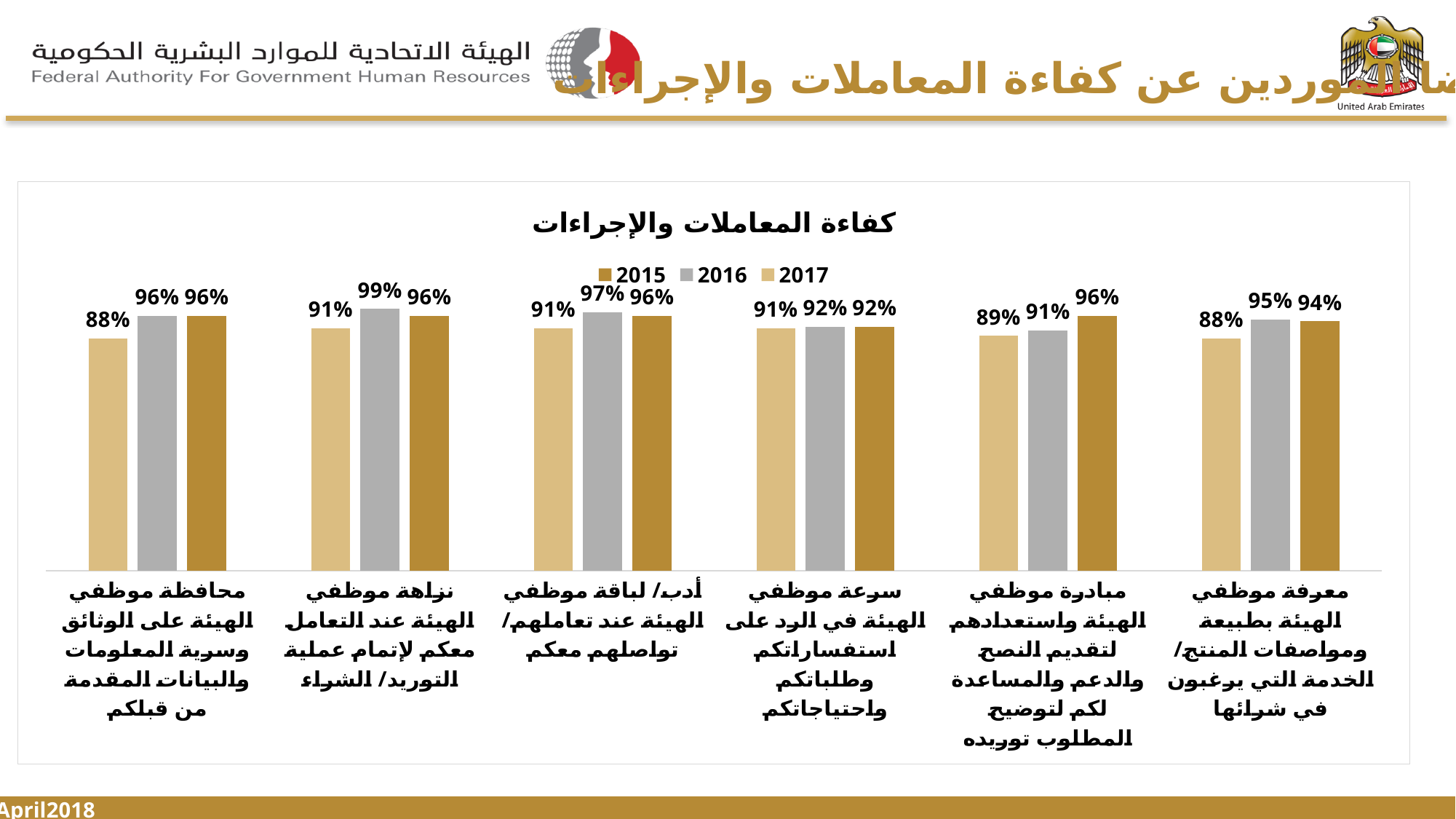
How many categories are shown on the x axis of the chart? 6 For "مبادرة موظفي الهيئة واستعدادهم لتقديم النصح والدعم والمساعدة لكم لتوضيح المطلوب توريده", which is larger, the 2015 value or the 2017 value? 2015 What is the 2016 value for "معرفة موظفي الهيئة بطبيعة ومواصفات المنتج/ الخدمة التي يرغبون في شرائها"? 95% What is the title of the chart? كفاءة المعاملات والإجراءات What is the 2016 value for "نزاهة موظفي الهيئة عند التعامل معكم لإتمام عملية التوريد/ الشراء"? 99% How many series does the legend of the chart list? 3 What type of chart is shown on the slide? Bar chart What is the difference between the 2016 and 2017 values for "محافظة موظفي الهيئة على الوثائق وسرية المعلومات والبيانات المقدمة من قبلكم"? 8% Which category has the lowest 2015 value? سرعة موظفي الهيئة في الرد على استفساراتكم وطلباتكم واحتياجاتكم What is the 2015 value for "مبادرة موظفي الهيئة واستعدادهم لتقديم النصح والدعم والمساعدة لكم لتوضيح المطلوب توريده"? 96% What is the 2017 value for "محافظة موظفي الهيئة على الوثائق وسرية المعلومات والبيانات المقدمة من قبلكم"? 88% Which category has the highest 2016 value? نزاهة موظفي الهيئة عند التعامل معكم لإتمام عملية التوريد/ الشراء